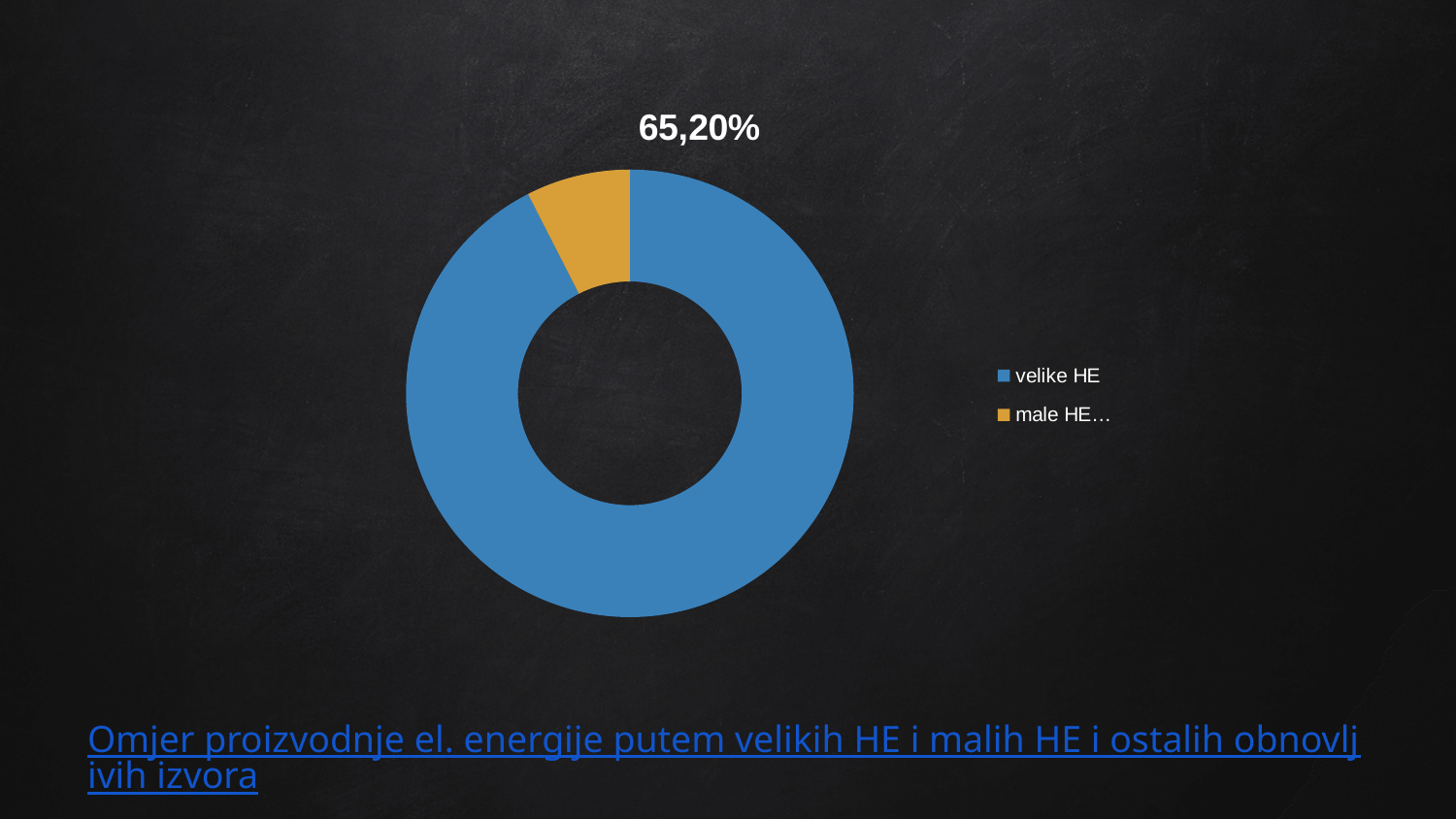
How many slices does the doughnut chart have? 2 Which slice is larger, velike HE or male HE…? velike HE What kind of chart is shown on the slide? doughnut (pie) chart Which category has the largest slice of the doughnut chart? velike HE What colour is the velike HE slice? blue How many entries does the legend list? 2 Which category has the smallest slice of the doughnut chart? male HE… What data label is printed above the doughnut chart? 65,20%